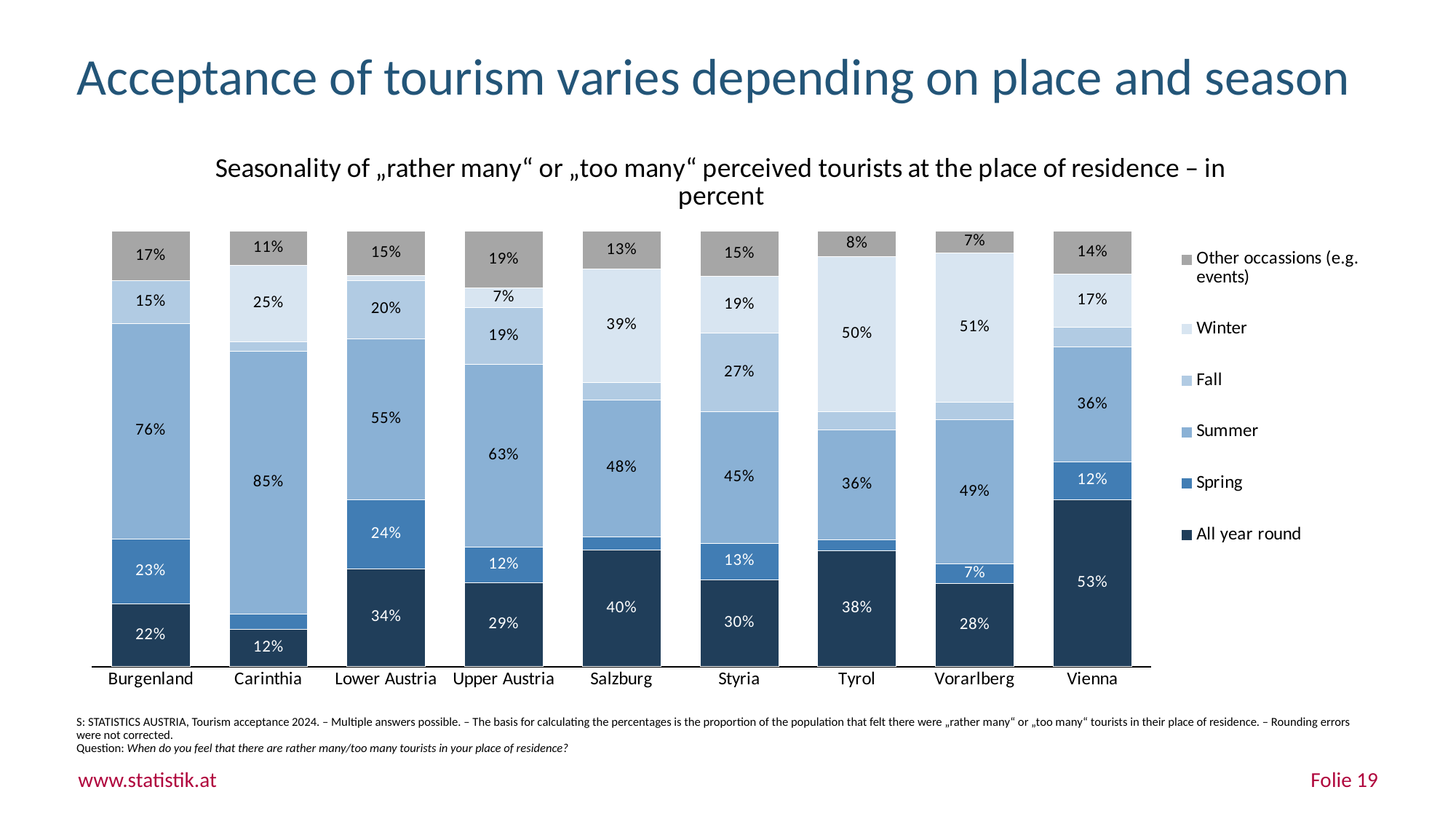
What kind of chart is shown on the slide? Stacked bar chart What is the Summer value for Carinthia? 85% How many regions are shown on the x axis? 9 Which region has the highest Summer value? Carinthia What is the Other occasions (e.g. events) value for Upper Austria? 19% Which legend entry is shown in the darkest blue colour? All year round How many series does the legend list? 6 Which has the larger Winter value, Salzburg or Styria? Salzburg Which region has the lowest All year round value? Carinthia Which region has the highest All year round value? Vienna What is the difference between the Summer values for Burgenland and Lower Austria? 21% What is the All year round value for Vienna? 53%